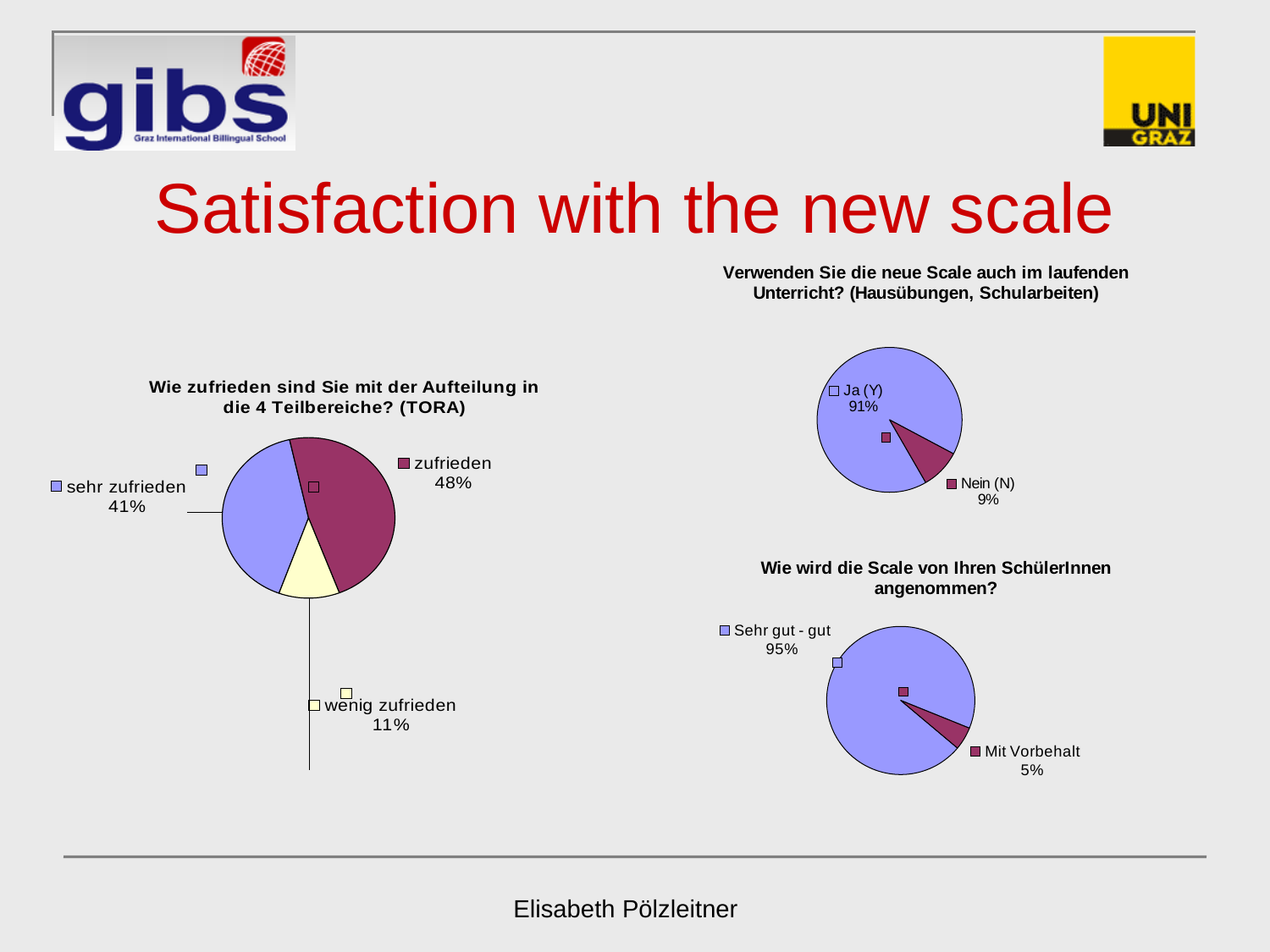
In the chart titled "Wie zufrieden sind Sie mit der Aufteilung in die 4 Teilbereiche? (TORA)", how many categories are shown? 3 In the chart titled "Wie wird die Scale von Ihren SchülerInnen angenommen?", what share is labelled for "Mit Vorbehalt"? 5% In the chart titled "Wie zufrieden sind Sie mit der Aufteilung in die 4 Teilbereiche? (TORA)", what share is labelled for "zufrieden"? 48% In the chart titled "Wie zufrieden sind Sie mit der Aufteilung in die 4 Teilbereiche? (TORA)", which category has the largest slice? zufrieden In the chart titled "Verwenden Sie die neue Scale auch im laufenden Unterricht? (Hausübungen, Schularbeiten)", what share is labelled for "Nein (N)"? 9% In the chart titled "Wie wird die Scale von Ihren SchülerInnen angenommen?", which is larger, "Sehr gut - gut" or "Mit Vorbehalt"? Sehr gut - gut In the chart titled "Wie zufrieden sind Sie mit der Aufteilung in die 4 Teilbereiche? (TORA)", which category has the smallest slice? wenig zufrieden In the chart titled "Wie zufrieden sind Sie mit der Aufteilung in die 4 Teilbereiche? (TORA)", what is the difference in percentage points between "zufrieden" and "sehr zufrieden"? 7 percentage points What kind of chart is the chart titled "Wie wird die Scale von Ihren SchülerInnen angenommen?"? Pie chart In the chart titled "Wie zufrieden sind Sie mit der Aufteilung in die 4 Teilbereiche? (TORA)", what share is labelled for "sehr zufrieden"? 41% In the chart titled "Wie zufrieden sind Sie mit der Aufteilung in die 4 Teilbereiche? (TORA)", what share is labelled for "wenig zufrieden"? 11% In the chart titled "Verwenden Sie die neue Scale auch im laufenden Unterricht? (Hausübungen, Schularbeiten)", what share is labelled for "Ja (Y)"? 91%